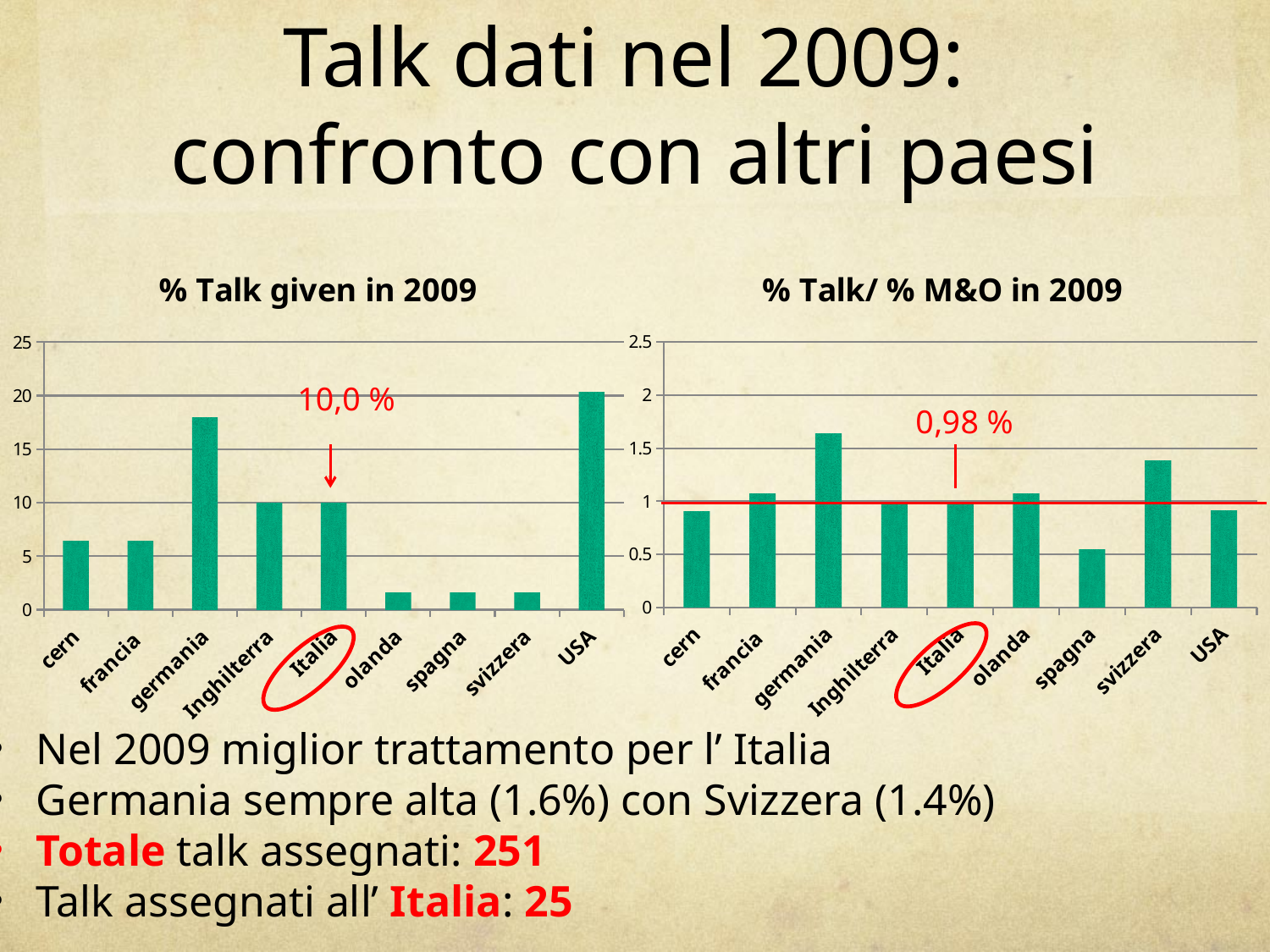
In the chart titled "% Talk given in 2009", which is larger, the value for germania or the value for Inghilterra? germania In the chart titled "% Talk/ % M&O in 2009", which country has the lowest bar? spagna How many countries are shown on the x axis of the chart titled "% Talk given in 2009"? 9 In the chart titled "% Talk/ % M&O in 2009", which country has the highest bar? germania In the chart titled "% Talk/ % M&O in 2009", is the value for svizzera greater or less than 1? greater In the chart titled "% Talk given in 2009", which country has the highest bar? USA In the chart titled "% Talk/ % M&O in 2009", what value is labelled for Italia? 0,98 % In the chart titled "% Talk given in 2009", what value is labelled for Italia? 10,0 % In the chart titled "% Talk/ % M&O in 2009", which is larger, the value for svizzera or the value for USA? svizzera In the chart titled "% Talk given in 2009", is the value for germania greater or less than 15? greater In the chart titled "% Talk/ % M&O in 2009", is the value for spagna greater or less than 1? less What type of chart is the chart titled "% Talk/ % M&O in 2009"? bar chart